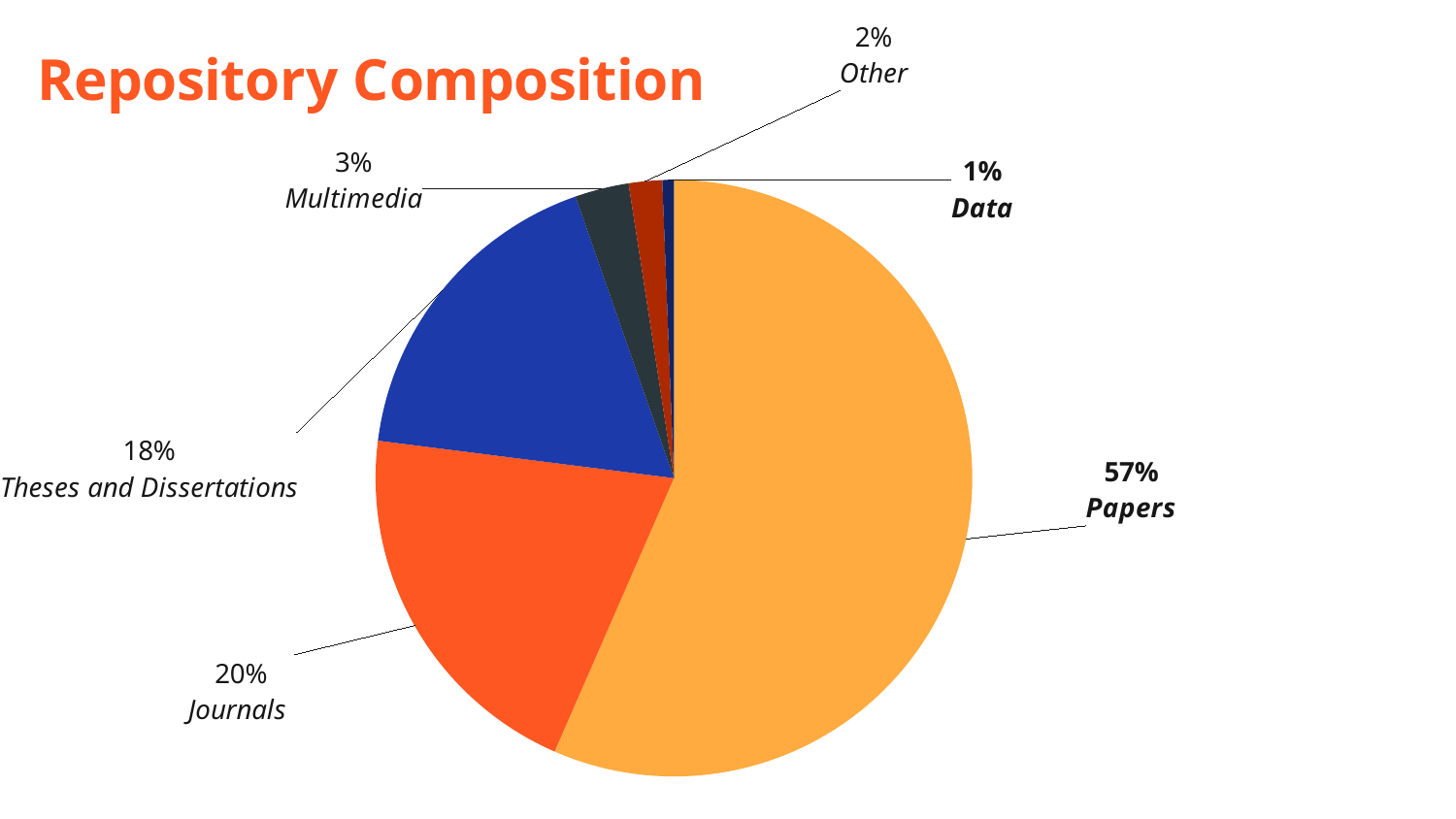
What share of the repository is Theses and Dissertations? 18% What share of the repository is Multimedia? 3% What is the title of the chart? Repository Composition How many categories are shown in the pie chart? 6 What kind of chart is shown on the slide? Pie chart Which category has the largest slice of the pie? Papers What share of the repository is Data? 1% What is the difference in percentage points between Journals and Theses and Dissertations? 2 Which category has the smallest slice of the pie? Data Which is larger, the share for Multimedia or the share for Other? Multimedia What share of the repository is Papers? 57% What share of the repository is Journals? 20%